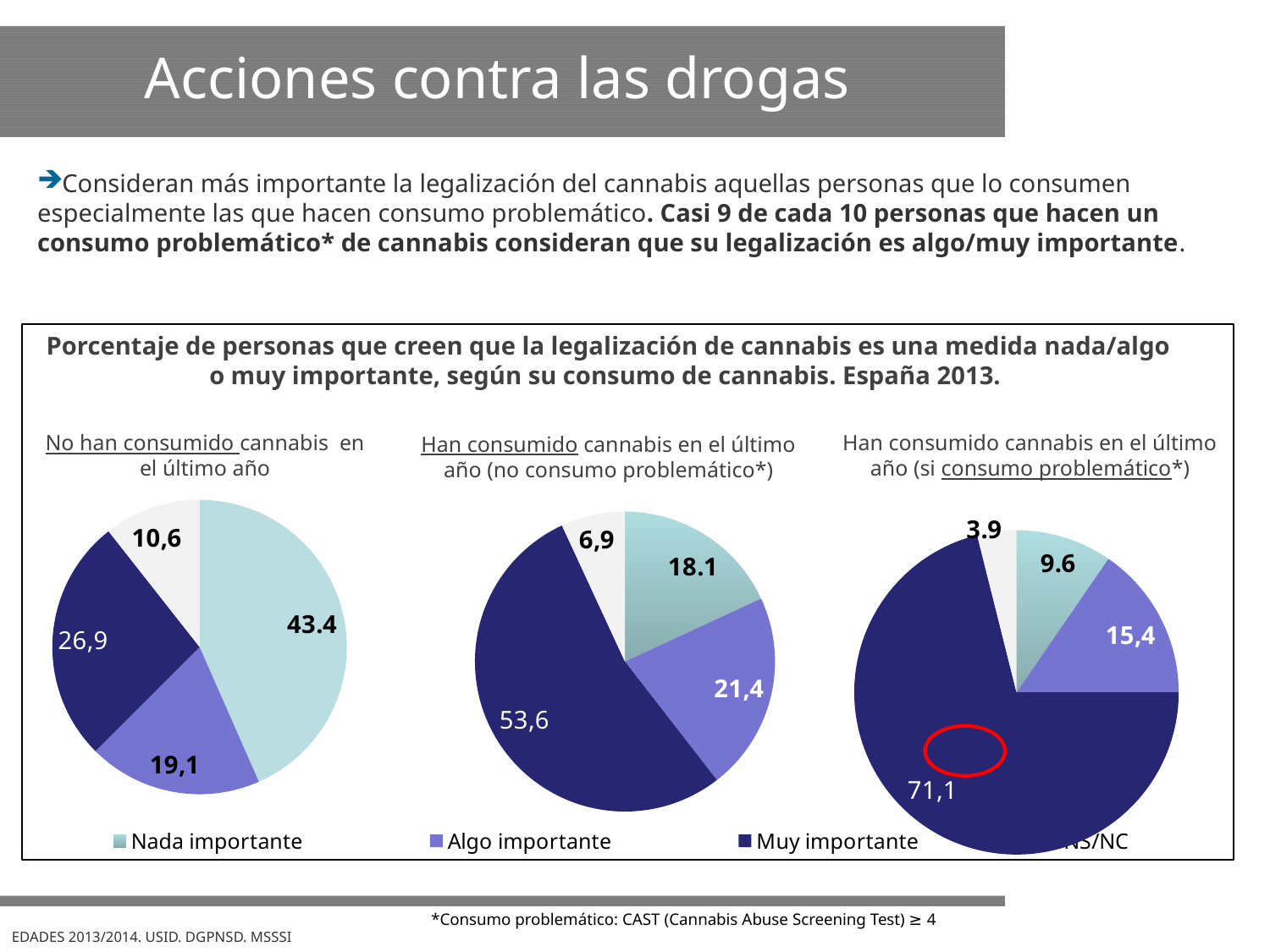
In the pie chart for 'No han consumido cannabis en el último año', which category has the largest slice? Nada importante In the pie chart for 'Han consumido cannabis en el último año (no consumo problemático*)', is the 'Algo importante' value larger than the 'Nada importante' value? Yes What kind of charts are shown on the slide? Pie charts In the pie chart for 'No han consumido cannabis en el último año', what is the value for 'Nada importante'? 43.4 In the pie chart for 'No han consumido cannabis en el último año', what is the difference between the 'Nada importante' and 'Algo importante' values? 24.3 In the pie chart for 'Han consumido cannabis en el último año (si consumo problemático*)', what is the value for 'Muy importante'? 71,1 In the pie chart for 'Han consumido cannabis en el último año (si consumo problemático*)', which category has the smallest slice? NS/NC In the pie chart for 'Han consumido cannabis en el último año (no consumo problemático*)', which category has the largest slice? Muy importante In the pie chart for 'Han consumido cannabis en el último año (si consumo problemático*)', what is the value for 'Nada importante'? 9.6 In the pie chart for 'Han consumido cannabis en el último año (no consumo problemático*)', what is the value for 'Muy importante'? 53,6 In the pie chart for 'Han consumido cannabis en el último año (si consumo problemático*)', what is the value for 'Algo importante'? 15,4 How many pie charts are shown on the slide? 3